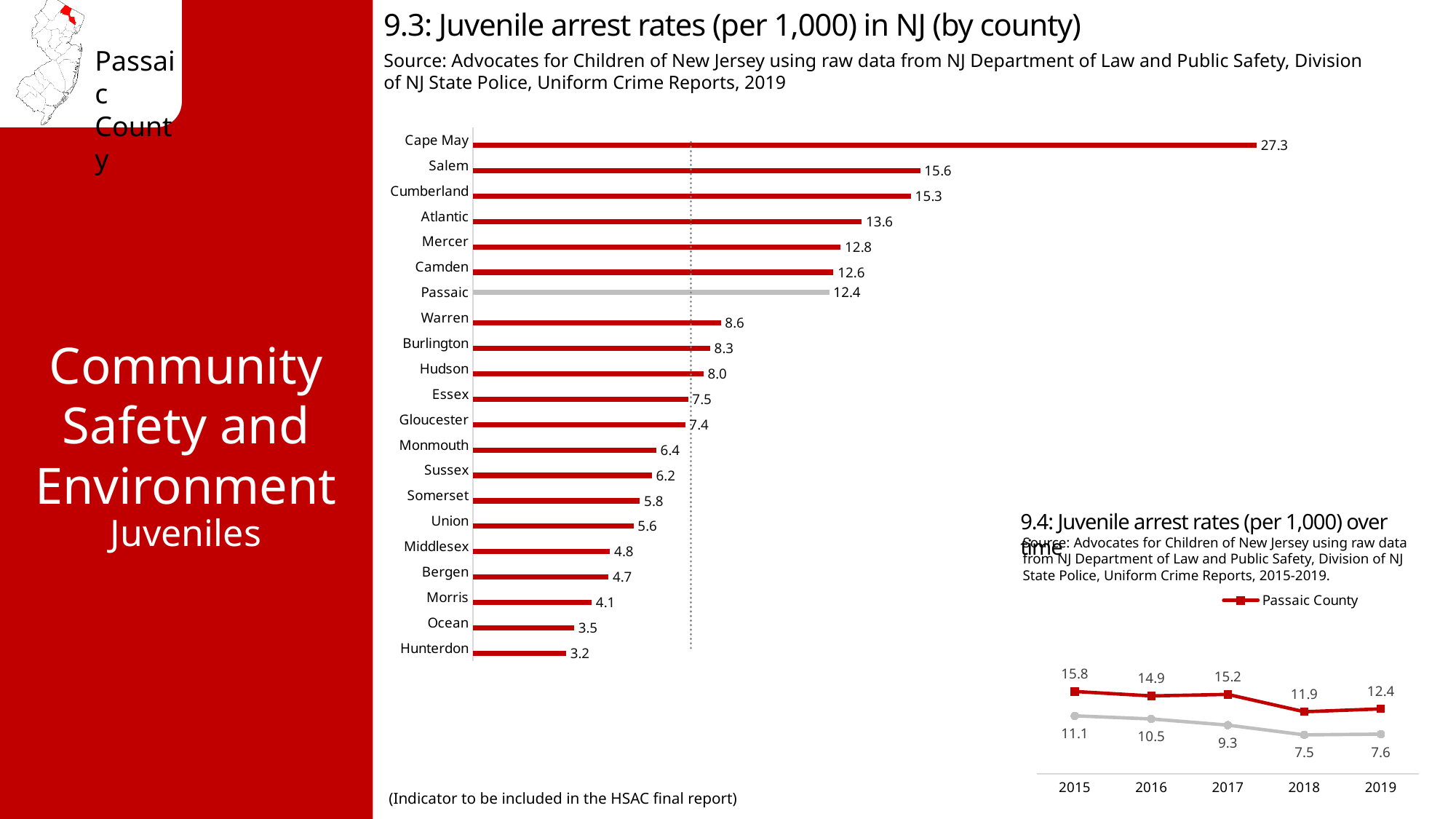
In chart 9.3 (juvenile arrest rates by county), what is the juvenile arrest rate for Passaic? 12.4 In chart 9.3 (juvenile arrest rates by county), what is the juvenile arrest rate for Bergen? 4.7 In chart 9.3 (juvenile arrest rates by county), what is the difference between the rates for Cape May and Salem? 11.7 In chart 9.4 (juvenile arrest rates over time), what is the Passaic County rate in 2018? 11.9 In chart 9.3 (juvenile arrest rates by county), which county has the highest juvenile arrest rate? Cape May In chart 9.3 (juvenile arrest rates by county), which has a higher juvenile arrest rate, Camden or Warren? Camden In chart 9.3 (juvenile arrest rates by county), how many counties are shown? 21 In chart 9.4 (juvenile arrest rates over time), what is the difference between the Passaic County rate in 2015 and in 2019? 3.4 In chart 9.4 (juvenile arrest rates over time), how many series does the legend list? 1 In chart 9.4 (juvenile arrest rates over time), in which year was the Passaic County rate highest? 2015 In chart 9.3 (juvenile arrest rates by county), which county has the lowest juvenile arrest rate? Hunterdon What kind of chart is chart 9.3 (juvenile arrest rates by county)? Bar chart